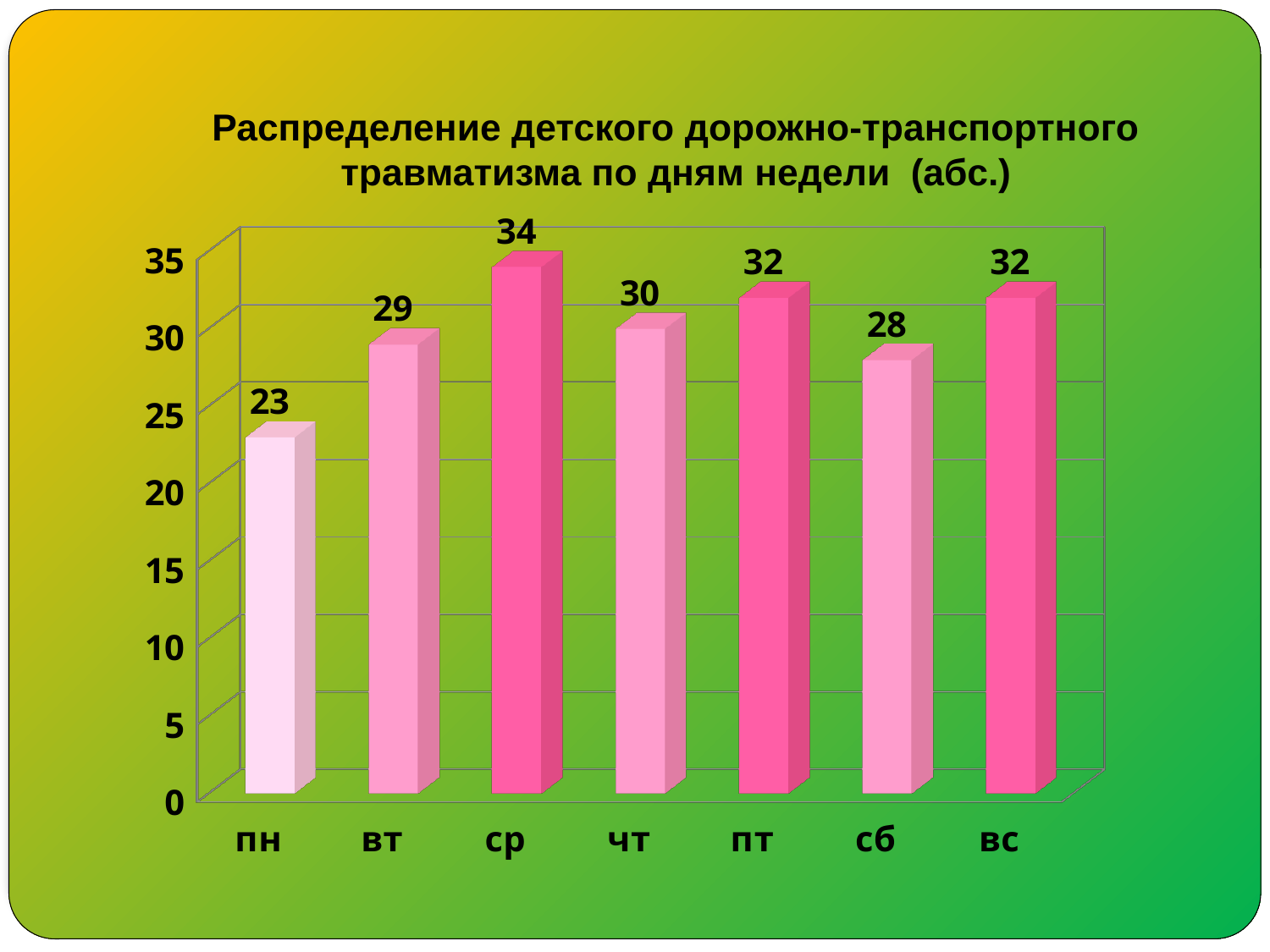
Is the value for пн greater or less than 25? less What is the difference between the values for ср and пн? 11 What is the difference between the values for чт and сб? 2 What is the value for ср? 34 Which day has the highest value? ср Which day has the lowest value? пн Which is larger, the value for вт or the value for чт? чт What kind of chart is shown on the slide? bar chart What is the title of the chart? Распределение детского дорожно-транспортного травматизма по дням недели (абс.) What is the value for сб? 28 How many days (categories) are shown on the x axis? 7 What is the value for пн? 23